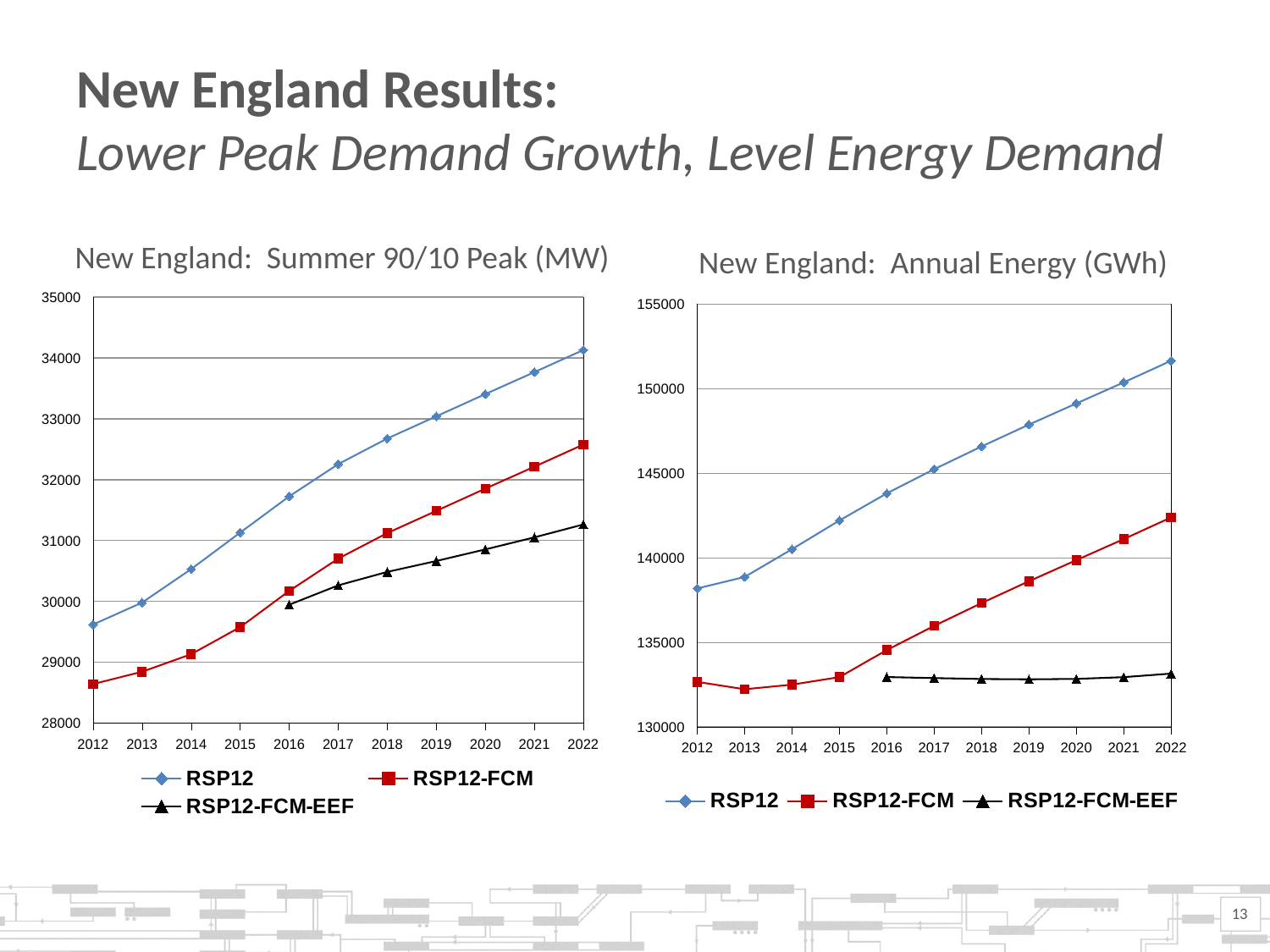
In the 'New England: Annual Energy (GWh)' chart, is the RSP12-FCM-EEF value for 2022 greater or less than 135000? less In the 'New England: Summer 90/10 Peak (MW)' chart, how many years are shown on the x axis? 11 In the 'New England: Summer 90/10 Peak (MW)' chart, is the RSP12 value for 2012 greater or less than 30000? less In the 'New England: Summer 90/10 Peak (MW)' chart, does the RSP12 series rise or fall from 2012 to 2022? rise In the 'New England: Annual Energy (GWh)' chart, is the RSP12 value for 2012 greater or less than 140000? less In the 'New England: Summer 90/10 Peak (MW)' chart, which series is plotted with black triangle markers? RSP12-FCM-EEF In the 'New England: Annual Energy (GWh)' chart, which series has the highest value in 2022? RSP12 How many series does the legend of the 'New England: Annual Energy (GWh)' chart list? 3 What type of chart is the 'New England: Summer 90/10 Peak (MW)' chart? line chart